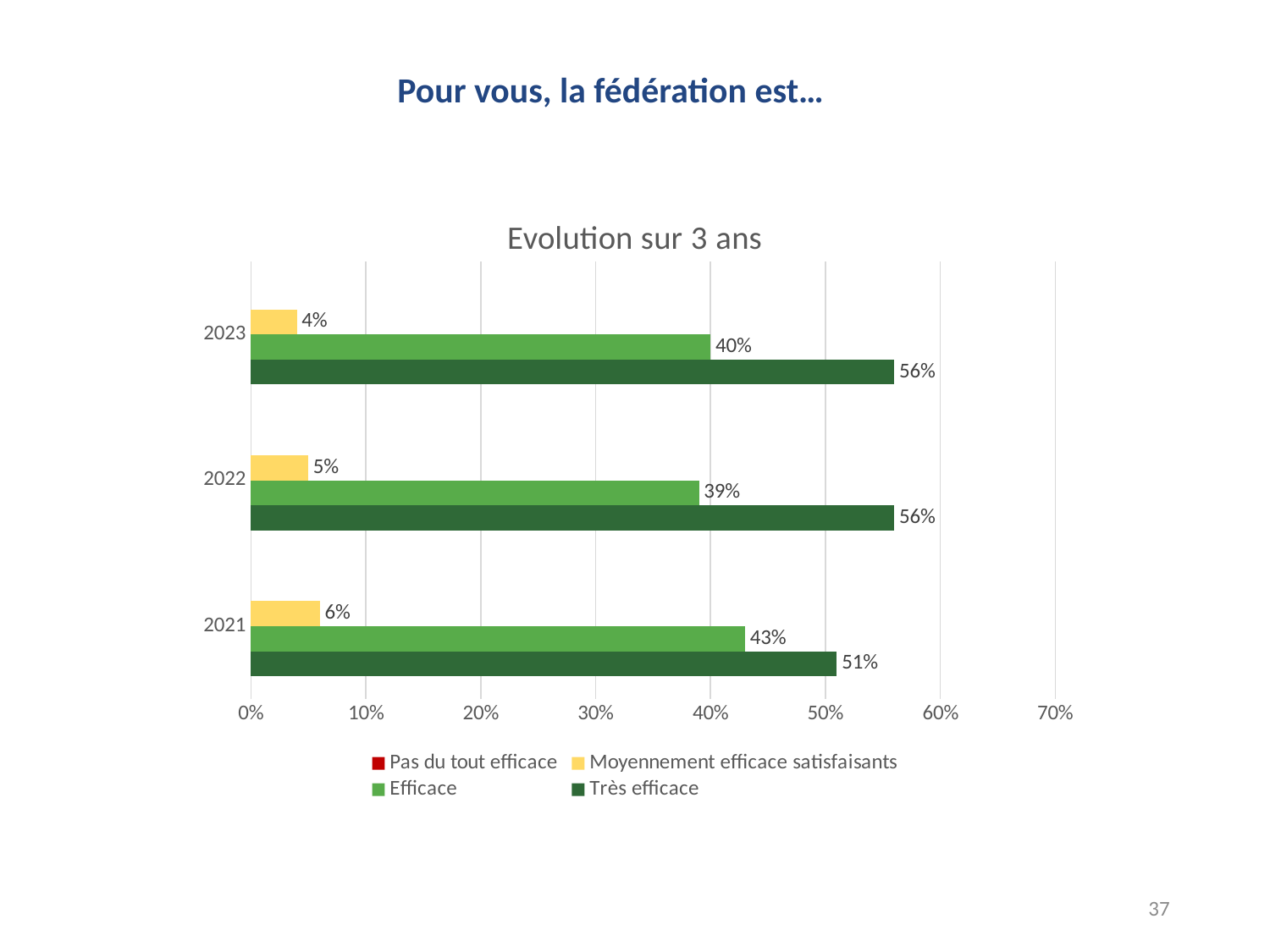
What is the value for 'Moyennement efficace satisfaisants' in 2022? 5% How many years are shown on the chart? 3 What is the title of the chart? Evolution sur 3 ans What is the difference between the 'Très efficace' values for 2023 and 2021? 5% In which year is the 'Moyennement efficace satisfaisants' value highest? 2021 In which year is the 'Très efficace' value lowest? 2021 What kind of chart is shown? Bar chart Which is larger in 2022: 'Efficace' or 'Très efficace'? Très efficace What is the value for 'Efficace' in 2021? 43% Is the value for 'Efficace' in 2023 greater or less than 30%? greater How many series does the legend list? 4 What is the value for 'Très efficace' in 2023? 56%